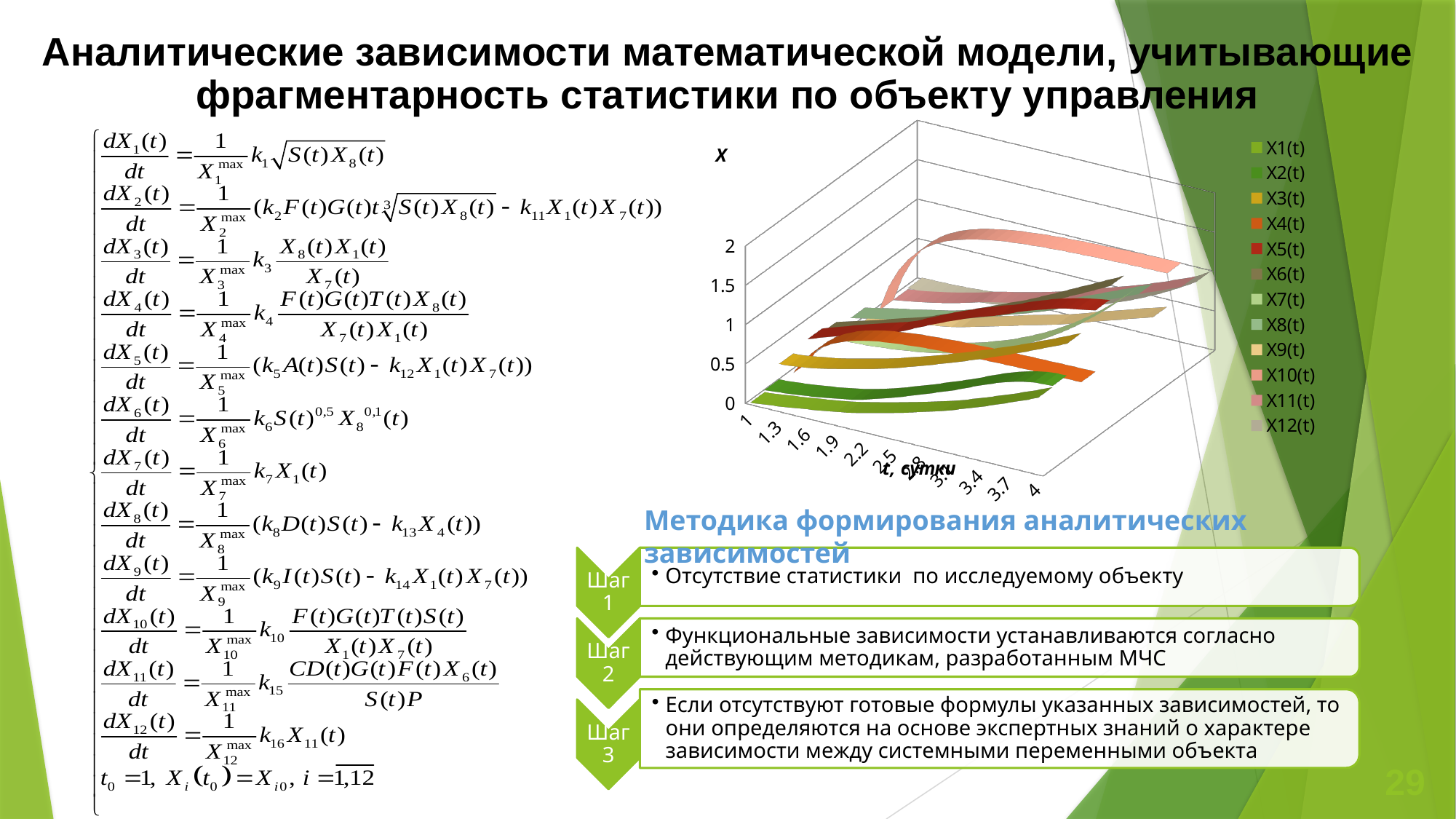
What is the highest tick value shown on the vertical axis of the chart? 2 Does the X1(t) series rise or fall as t increases from 1 to 4? rises What is the label of the last series in the chart legend? X12(t) What is the last tick label on the horizontal (t) axis of the chart? 4 Is the value of X1(t) at t = 1 greater or less than 0.5? less How many series does the chart legend list? 12 What kind of chart is shown on the slide? 3D line (ribbon) chart How many tick labels are shown along the t axis of the chart? 11 What is the label of the first series in the chart legend? X1(t) What is the first tick label on the horizontal (t) axis of the chart? 1